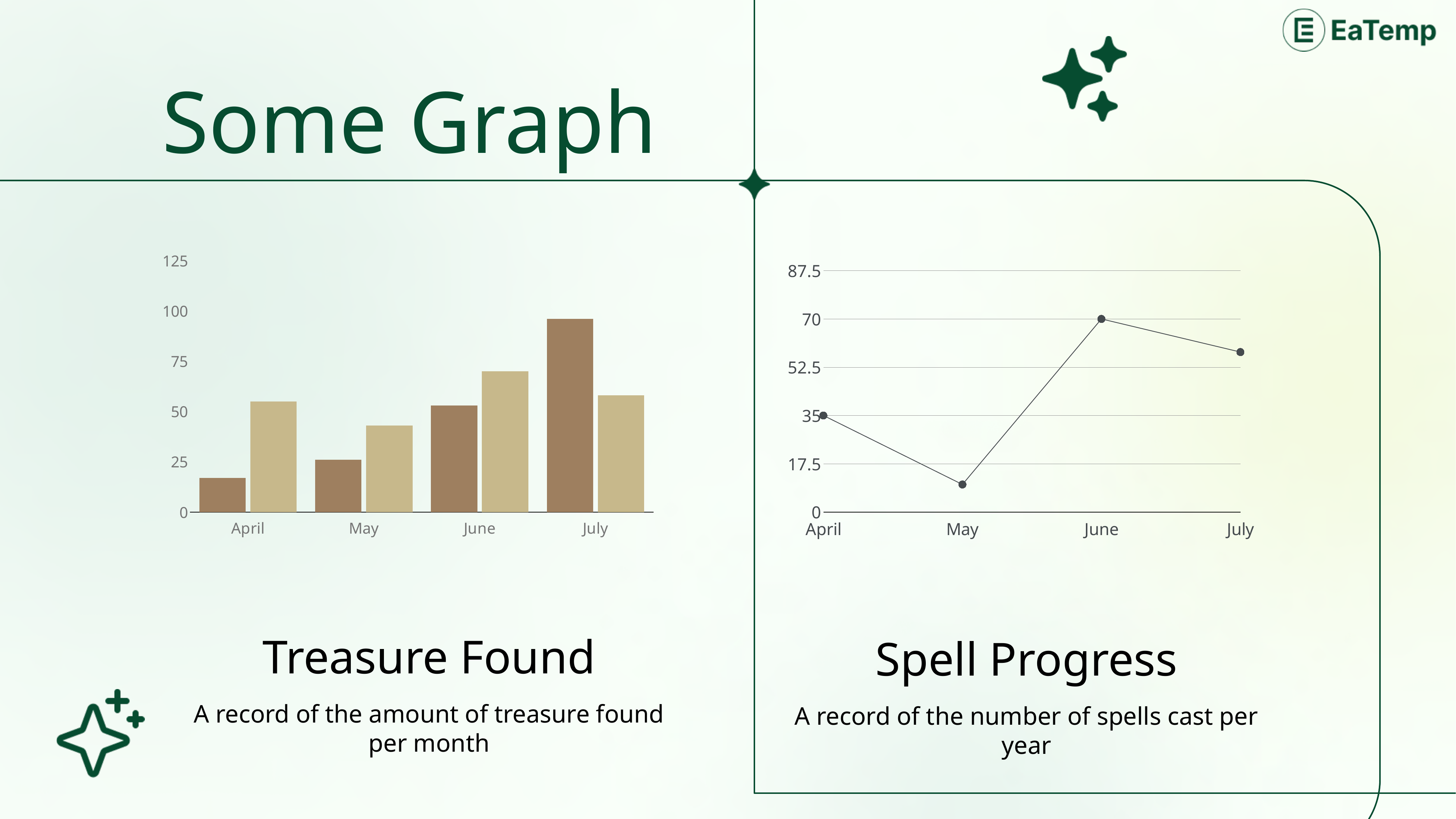
In the Spell Progress chart, which month has the highest value? June In the Treasure Found chart, how many months are shown on the x axis? 4 In the Spell Progress chart, how many data points are plotted? 4 In the Spell Progress chart, what is the value for April? 35 What kind of chart is the Spell Progress chart on the right? line chart In the Spell Progress chart, is the value for May greater or less than 17.5? less In the Treasure Found chart, is the dark brown bar for July greater or less than 75? greater In the Spell Progress chart, which month has the lowest value? May In the Spell Progress chart, is the value for July greater or less than 52.5? greater What kind of chart is the Treasure Found chart on the left? bar chart In the Spell Progress chart, what is the value for June? 70 In the Spell Progress chart, what is the difference between the June value and the April value? 35